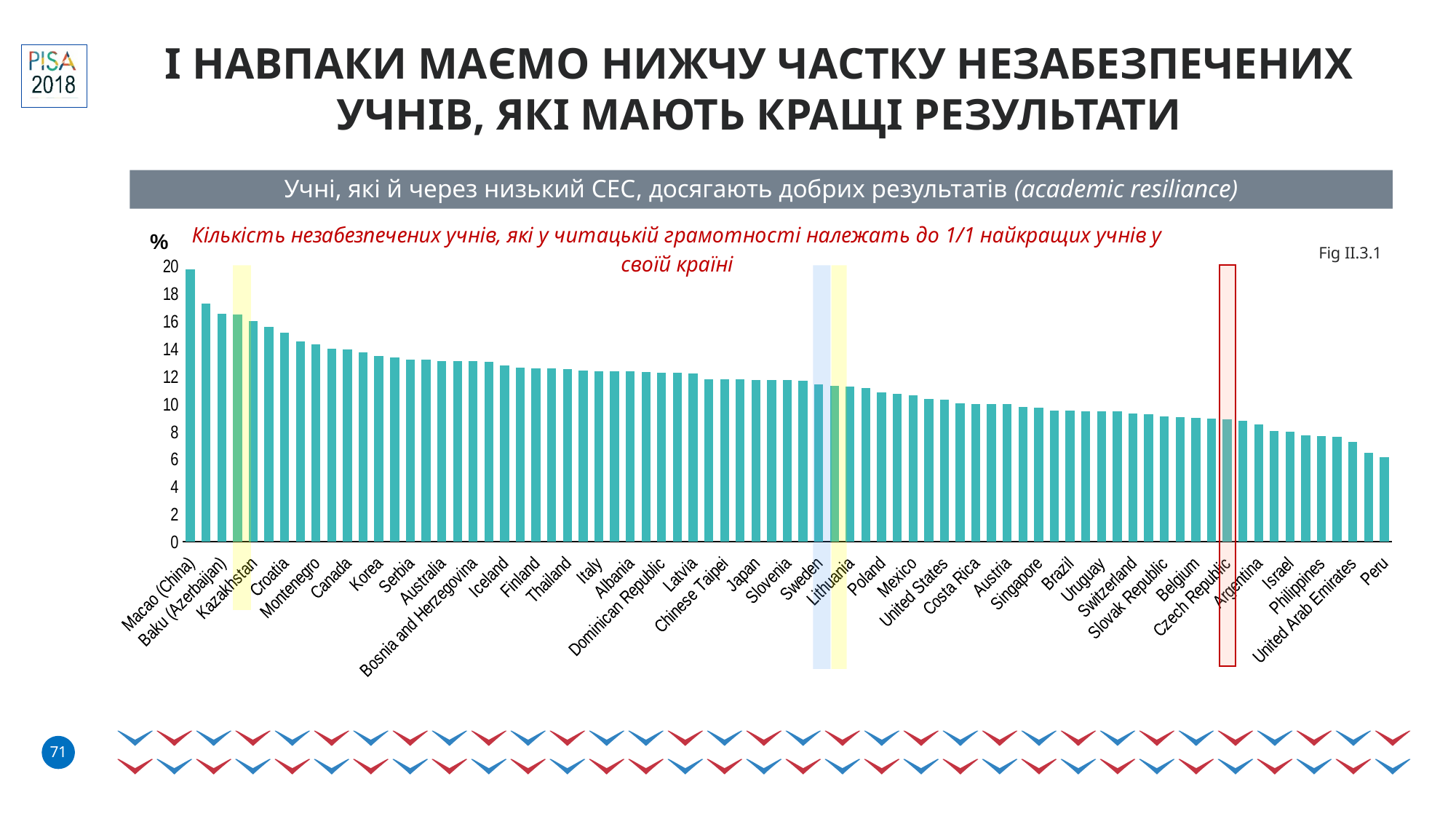
What unit is shown on the y axis of the chart? % Do the bar values rise or fall from left to right along the x axis? fall Is the value for Czech Republic greater or less than 10? less Is the value for Lithuania greater or less than 10? greater Which country has the lowest value in the chart? Peru Is the value for Kazakhstan greater or less than 14? greater Which country has the highest share of disadvantaged students among top readers? Macao (China) What figure reference is printed next to the chart? Fig II.3.1 Which has a larger value, Kazakhstan or Czech Republic? Kazakhstan What type of chart is shown on the slide? bar chart